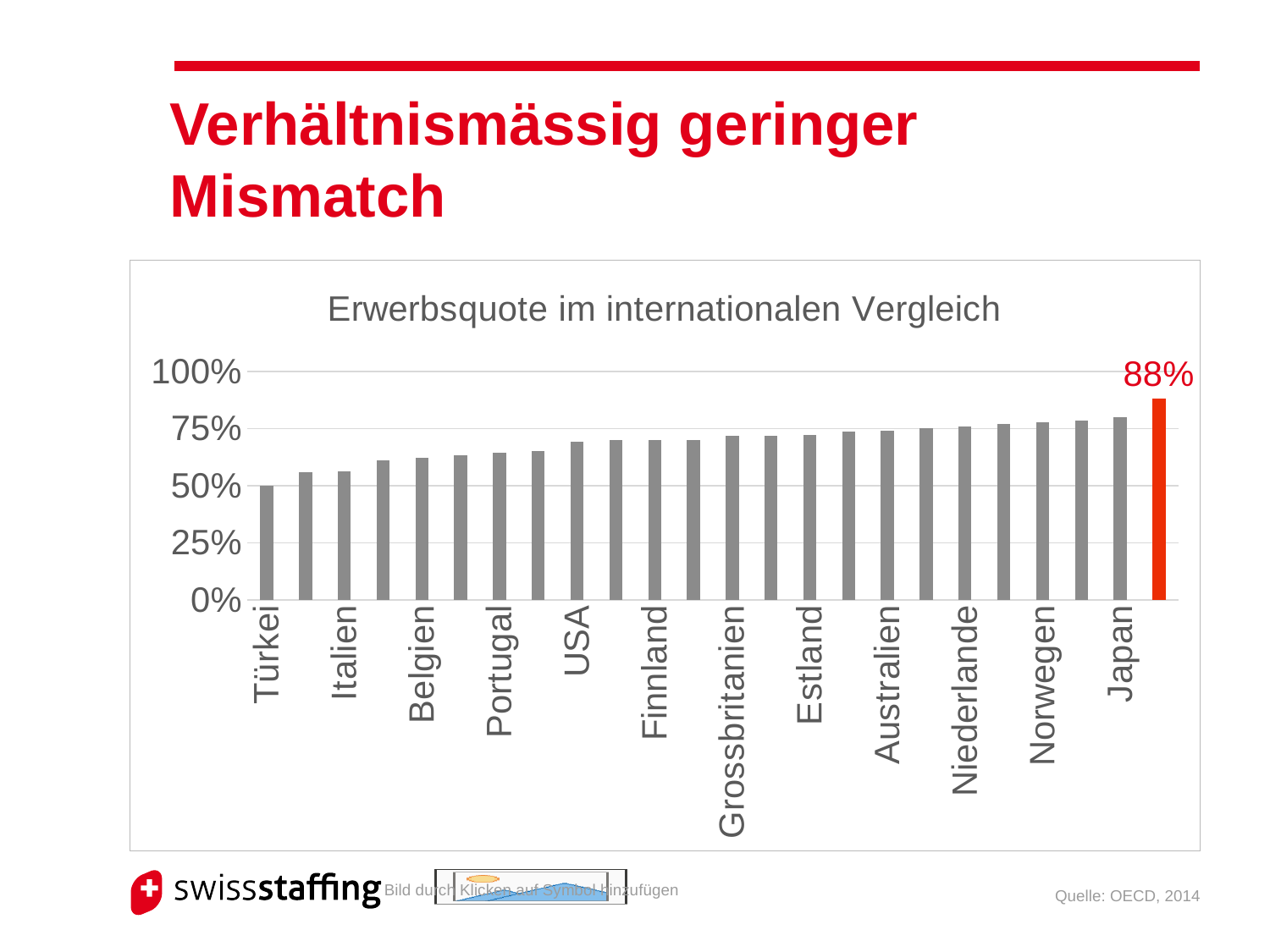
Is the value for Japan greater or less than 75%? greater Which has the larger value, Japan or Türkei? Japan What value is printed as a data label on the red bar? 88% Which labelled country has the highest bar among the grey bars? Japan How many country labels are shown on the x axis? 12 Do the bar values rise or fall from left to right along the x axis? rise Is the value for USA greater or less than 75%? less Which has the larger value, Norwegen or Italien? Norwegen Which labelled country has the lowest bar in the chart? Türkei What is the title of the chart? Erwerbsquote im internationalen Vergleich Is the value for Italien greater or less than 50%? greater What kind of chart is shown on the slide? bar chart